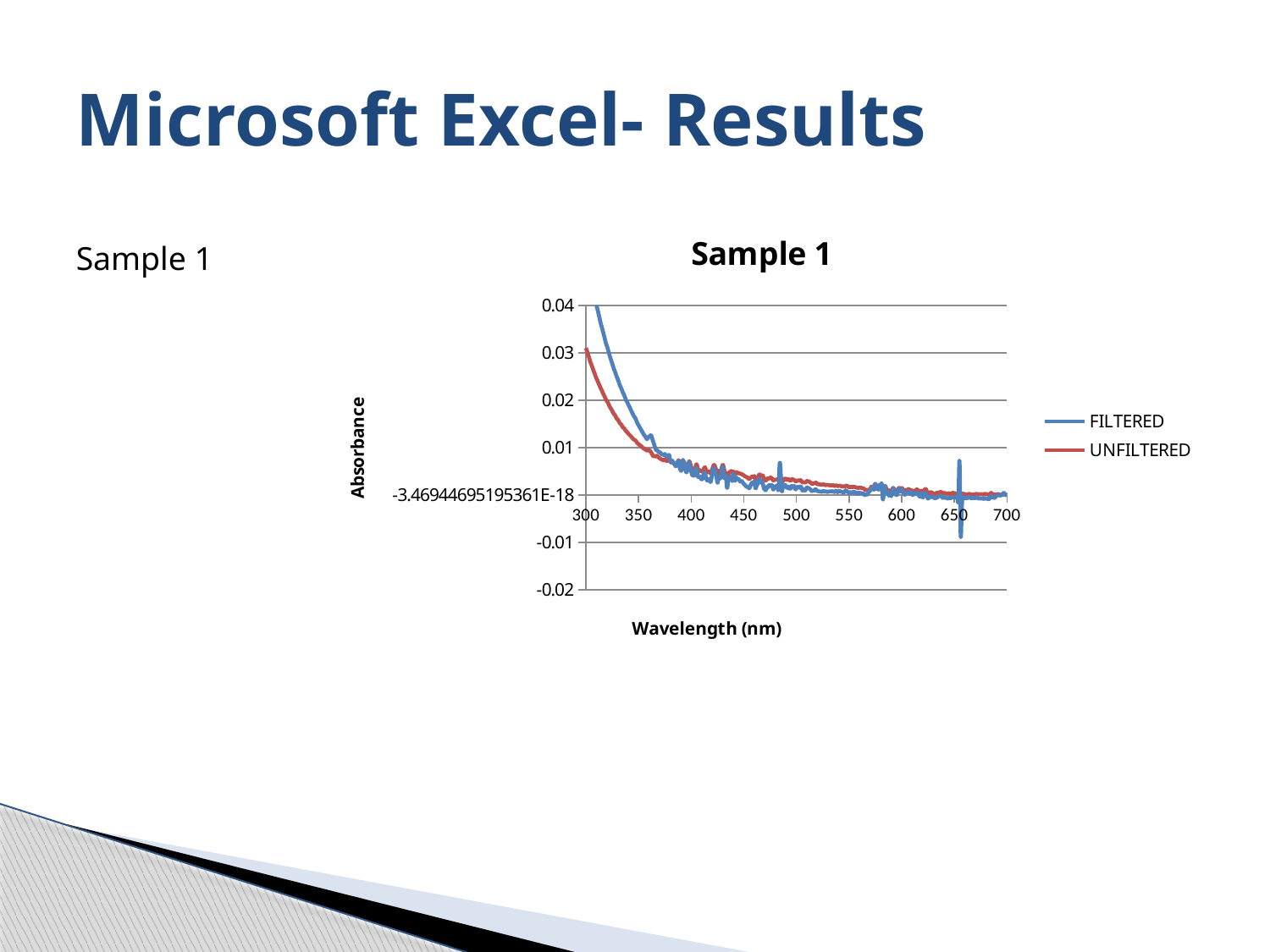
What is the title of the chart on the slide? Sample 1 Is the UNFILTERED absorbance at 700 nm greater or less than 0.01? less Is the FILTERED absorbance at 300 nm greater or less than 0.03? greater What are the two series named in the legend of the Sample 1 chart? FILTERED and UNFILTERED Do the absorbance values in the Sample 1 chart rise or fall as wavelength increases from 300 nm to 700 nm? fall What kind of chart is shown on the slide? line chart How many series does the legend of the Sample 1 chart list? 2 What is the highest value labelled on the y axis of the Sample 1 chart? 0.04 Is the UNFILTERED absorbance at 300 nm greater or less than 0.02? greater Which series is drawn in blue in the Sample 1 chart? FILTERED At 300 nm, which series has the higher absorbance in the Sample 1 chart, FILTERED or UNFILTERED? FILTERED